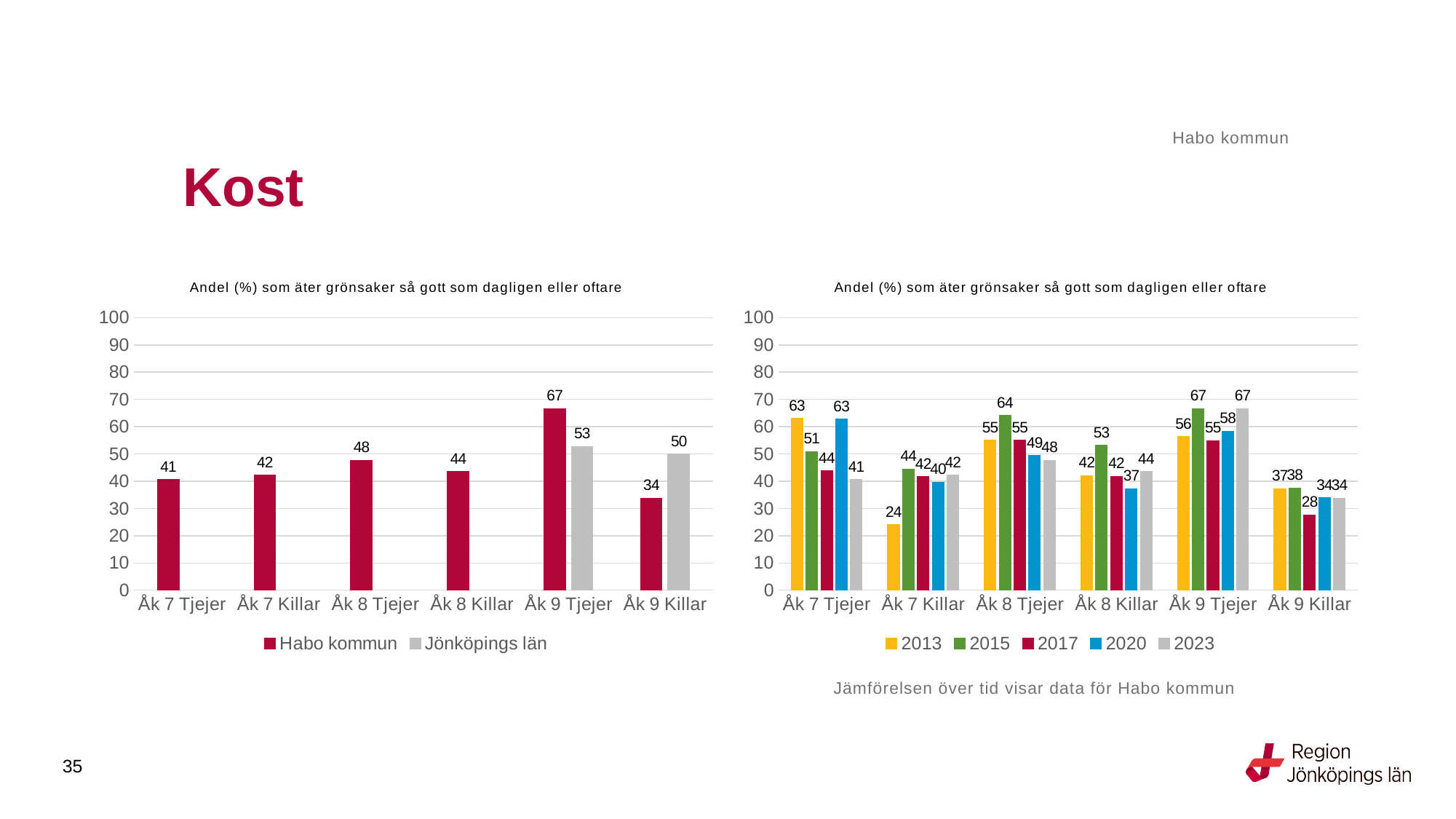
In the left chart, which category has the lowest Habo kommun value? Åk 9 Killar In the right chart, what is the value for 2020 for Åk 8 Tjejer? 49 In the right chart, which year has the highest value for Åk 8 Killar? 2015 In the left chart, what is the difference between the Habo kommun and Jönköpings län values for Åk 9 Tjejer? 14 What kind of chart is the right chart? bar chart In the right chart, how many series does the legend list? 5 In the right chart, what is the value for 2013 for Åk 7 Killar? 24 In the left chart, what is the value for Jönköpings län for Åk 9 Killar? 50 In the left chart, what is the value for Habo kommun for Åk 9 Tjejer? 67 In the right chart, is the 2017 value for Åk 9 Killar larger or smaller than the 2023 value for Åk 9 Killar? smaller In the left chart, how many categories are shown on the x axis? 6 In the left chart, how many series does the legend list? 2